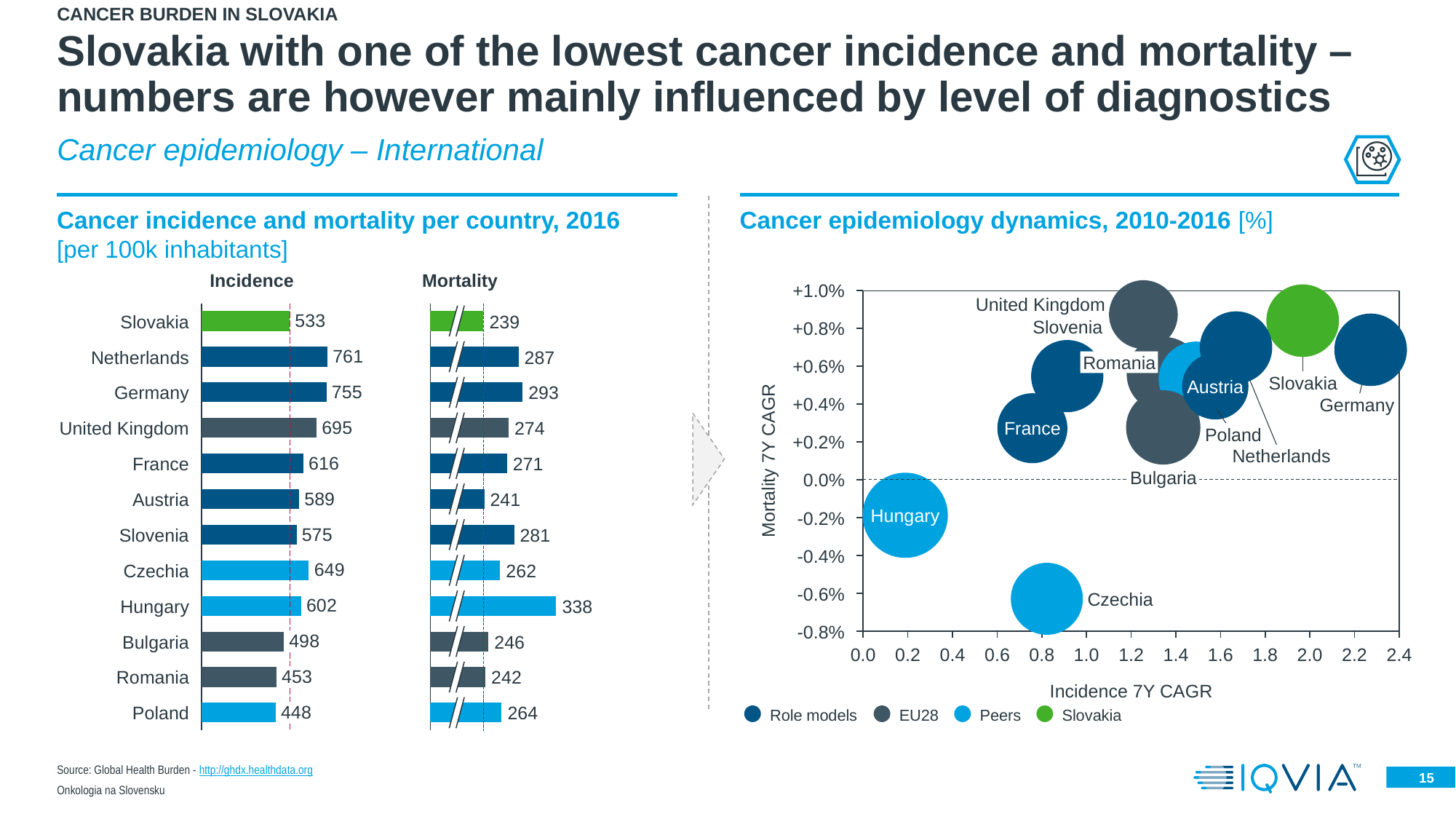
In the 'Cancer incidence and mortality per country, 2016' chart, which country has the lowest incidence? Poland In the 'Cancer incidence and mortality per country, 2016' chart, what is the incidence value for Slovakia? 533 In the 'Cancer incidence and mortality per country, 2016' chart, which has the higher mortality, Germany or Austria? Germany What kind of chart is the 'Cancer incidence and mortality per country, 2016' chart? Bar chart In the 'Cancer incidence and mortality per country, 2016' chart, what is the mortality value for Hungary? 338 How many countries are shown in the 'Cancer incidence and mortality per country, 2016' chart? 12 In the 'Cancer incidence and mortality per country, 2016' chart, which country has the lowest mortality? Slovakia How many entries does the legend of the 'Cancer epidemiology dynamics, 2010-2016' chart list? 4 In the 'Cancer epidemiology dynamics, 2010-2016' chart, is the Incidence 7Y CAGR for Germany greater or less than 2.0? greater In the 'Cancer incidence and mortality per country, 2016' chart, which country has the highest incidence? Netherlands In the 'Cancer incidence and mortality per country, 2016' chart, what is the difference between the incidence of Netherlands and Slovakia? 228 In the 'Cancer epidemiology dynamics, 2010-2016' chart, is the Mortality 7Y CAGR for Czechia greater or less than -0.4%? less